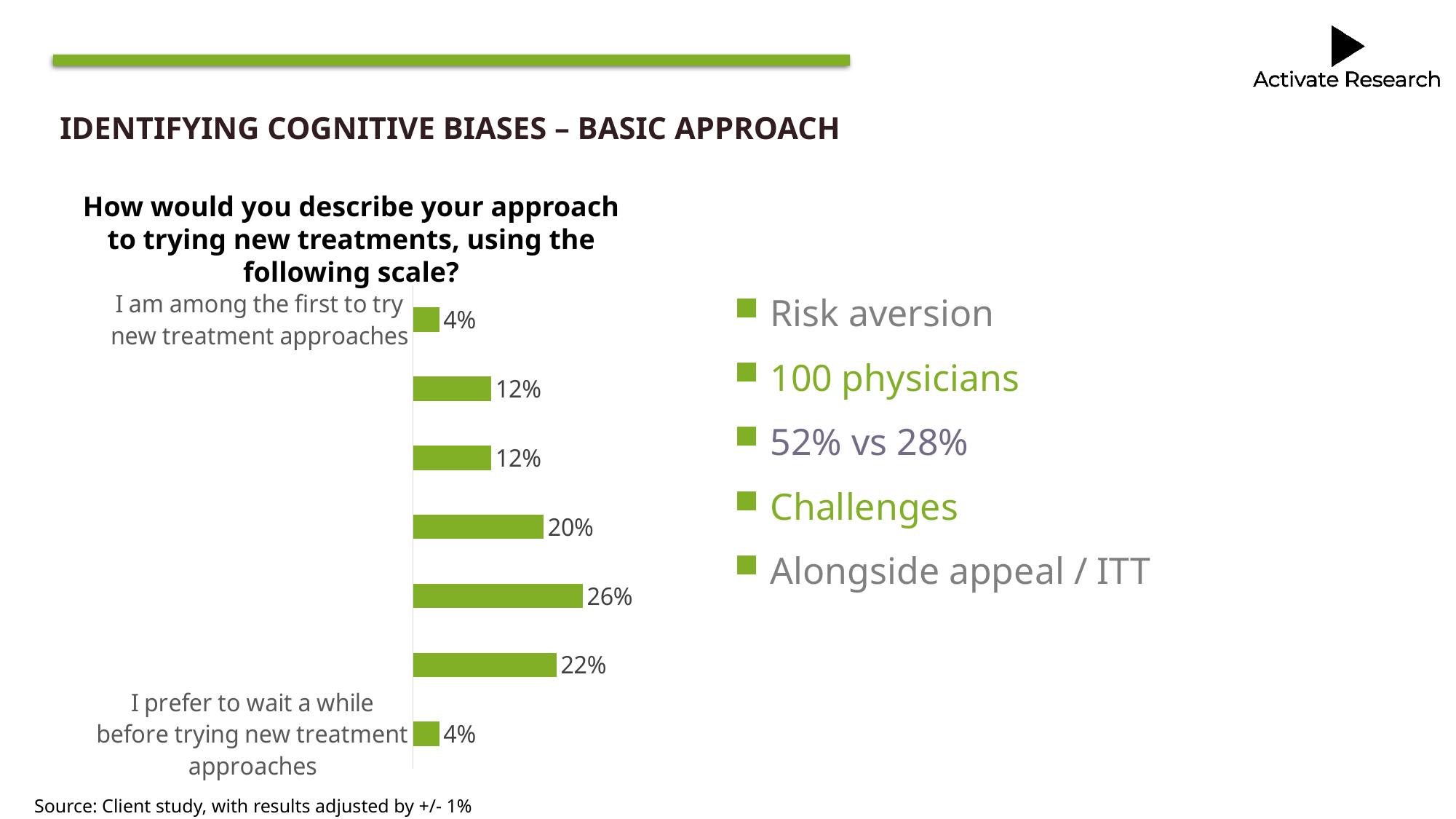
What is the title of the chart? How would you describe your approach to trying new treatments, using the following scale? What is the difference between the highest value (26%) and the value for "I am among the first to try new treatment approaches"? 22% What is the lowest value shown in the chart? 4% What is the value of the fourth bar from the top? 20% What is the highest value shown in the chart? 26% Which is larger: the fifth bar from the top or the sixth bar from the top? The fifth bar (26%) What type of chart is shown on the slide? Bar chart What is the value of the sixth bar from the top? 22% How many bars are plotted in the chart? 7 What is the source note printed below the chart? Source: Client study, with results adjusted by +/- 1% What percentage of respondents said "I prefer to wait a while before trying new treatment approaches"? 4% What percentage of respondents said "I am among the first to try new treatment approaches"? 4%